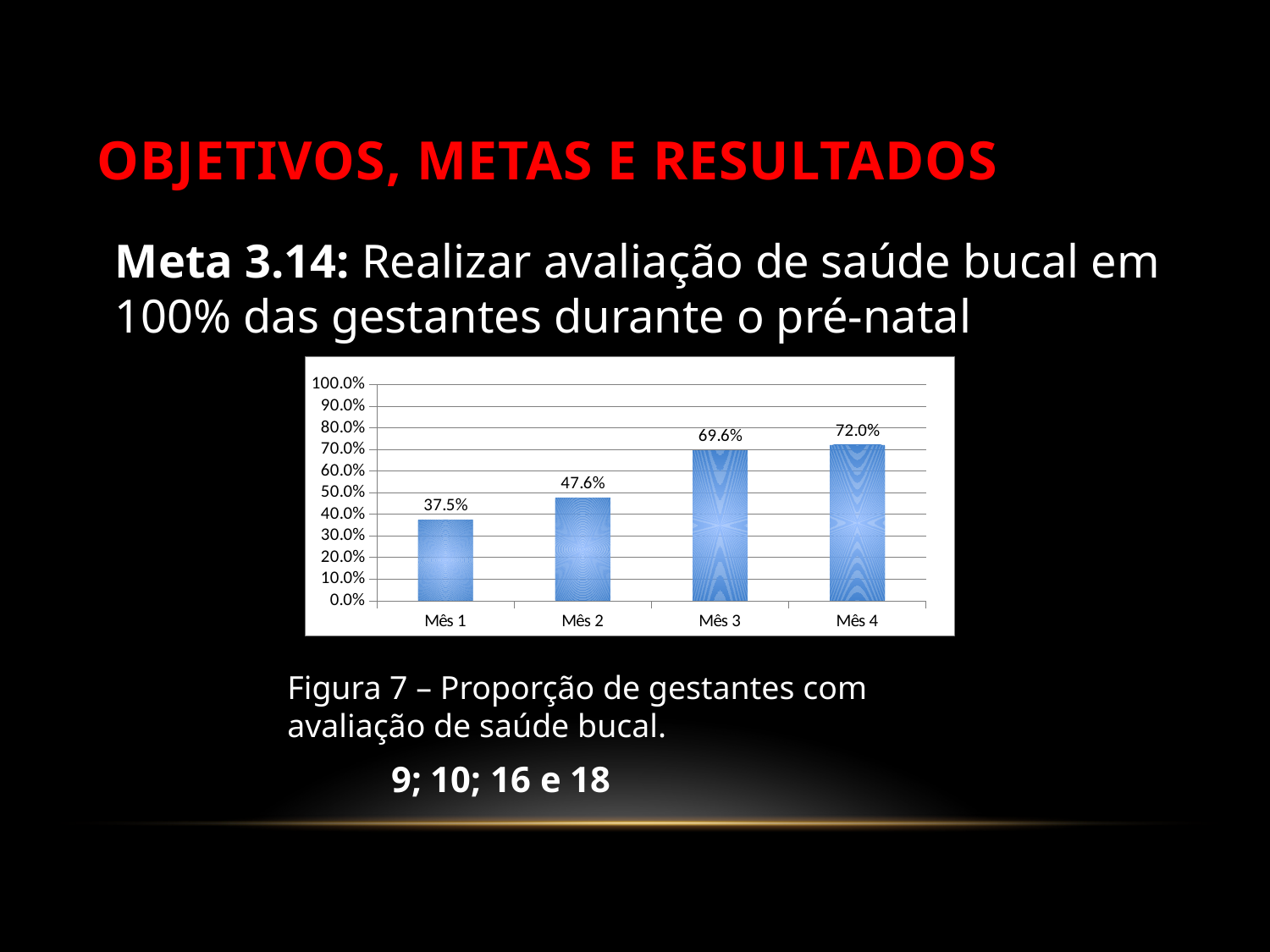
What is the value for Mês 4? 72.0% What is the difference between the values for Mês 3 and Mês 2? 22.0% Which month has the lowest value? Mês 1 Which month has the highest value? Mês 4 What is the value for Mês 1? 37.5% How many months are shown on the x axis? 4 What is the value for Mês 2? 47.6% What kind of chart is shown on the slide? Bar chart What is the value for Mês 3? 69.6% What is the difference between the values for Mês 4 and Mês 1? 34.5% Which is larger, the value for Mês 2 or the value for Mês 3? Mês 3 Do the values rise or fall from Mês 1 to Mês 4? Rise